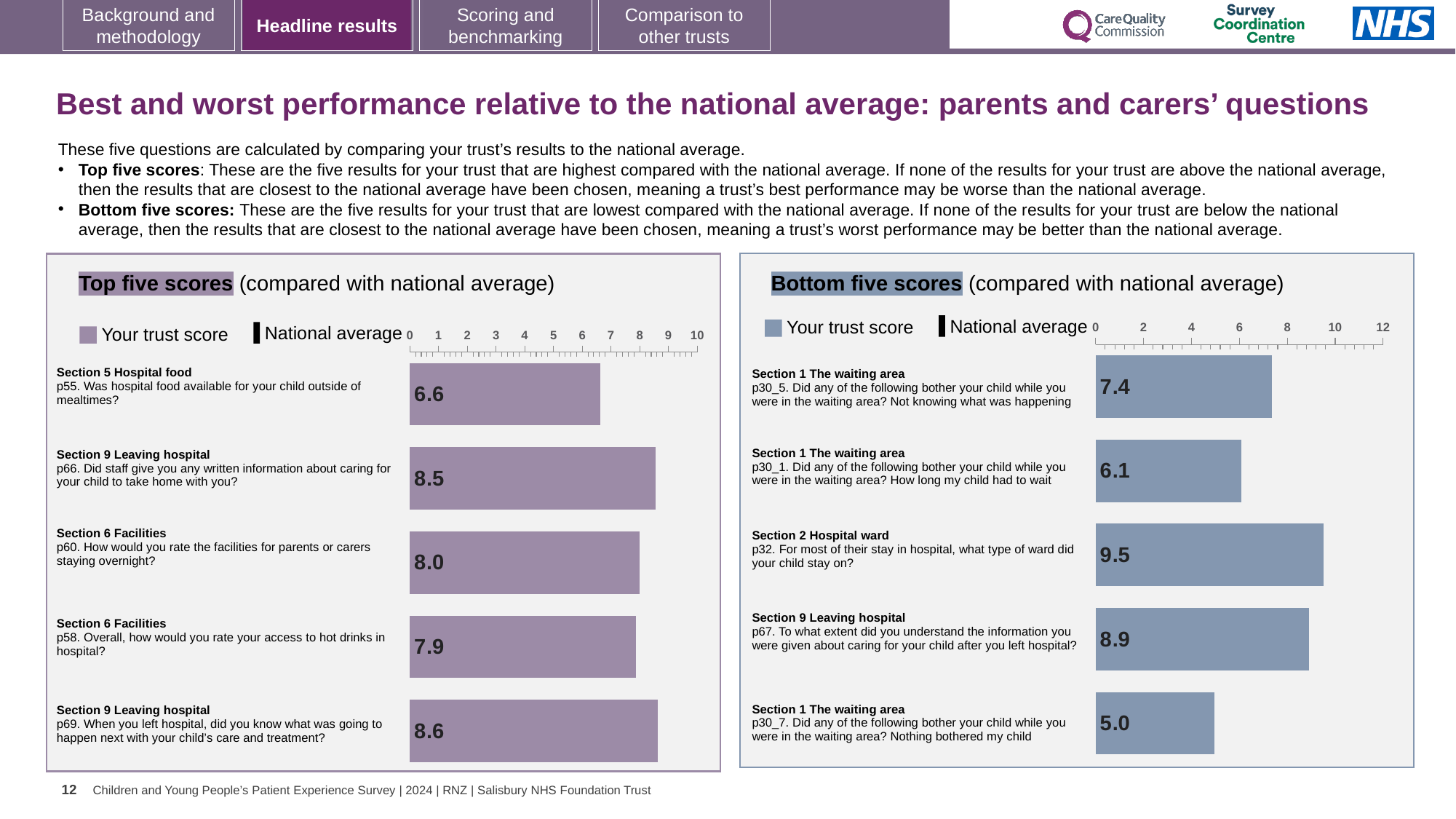
How many series does the legend of the Bottom five scores chart list? 2 In the Bottom five scores chart, what is the difference between the trust scores for p32 and p30_7? 4.5 In the Bottom five scores chart, is the trust score for p67 greater or less than 8? greater In the Bottom five scores chart, what is the trust score for p32 (what type of ward did your child stay on)? 9.5 In the Top five scores chart, what is the trust score for p66 (written information about caring for your child to take home)? 8.5 In the Top five scores chart, what is the difference between the trust scores for p69 and p55? 2.0 In the Bottom five scores chart, which question has the lowest trust score? p30_7 (5.0) In the Top five scores chart, what is the trust score for p58 (access to hot drinks in hospital)? 7.9 In the Bottom five scores chart, which has the larger trust score: p30_5 (not knowing what was happening) or p30_1 (how long my child had to wait)? p30_5 How many bars are plotted in the Top five scores chart? 5 In the Top five scores chart, which question has the highest trust score? p69 (8.6) What kind of chart is the Top five scores chart? Bar chart